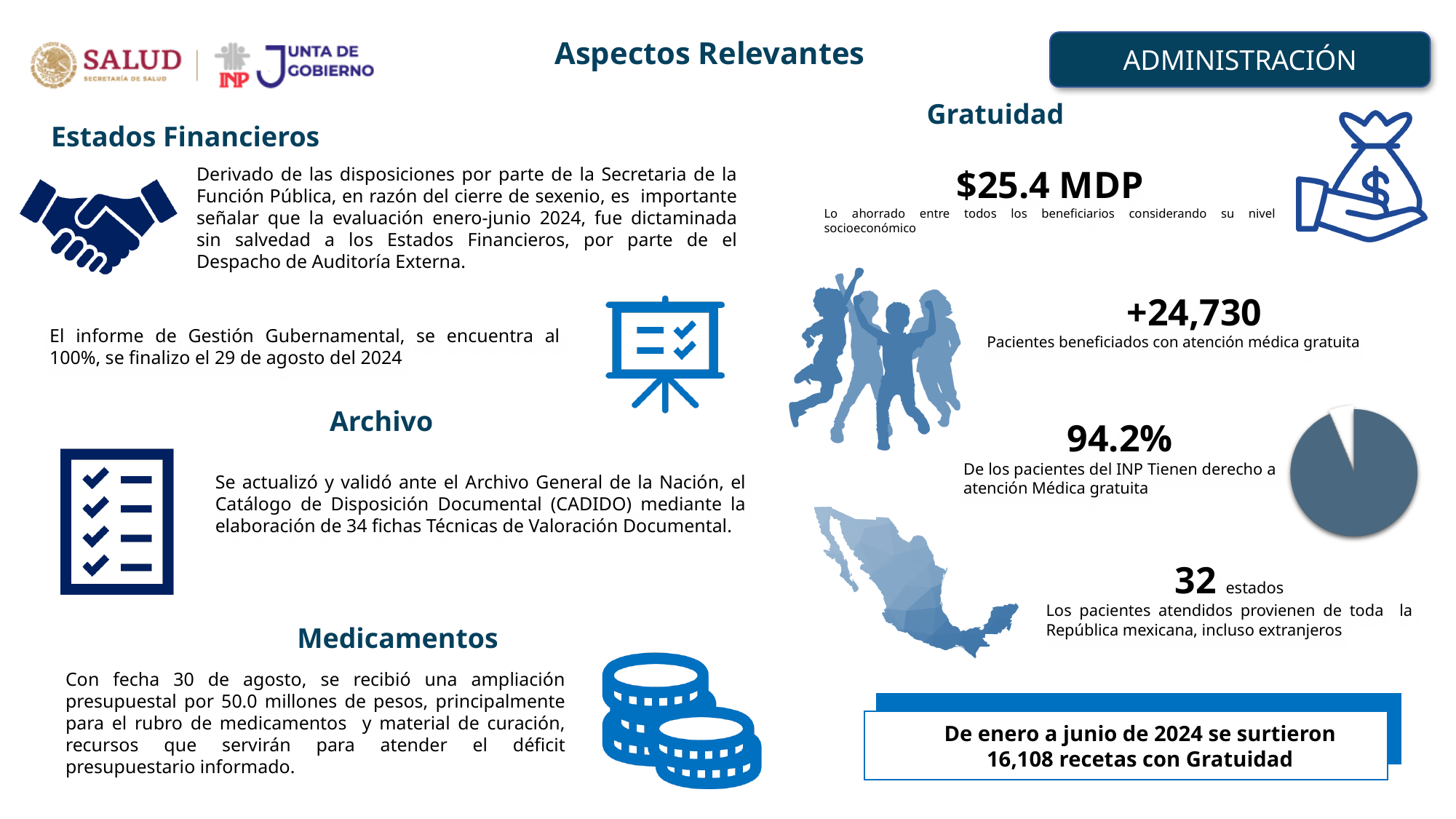
In the pie chart next to the 94.2% figure, is the dark slice or the white slice larger? the dark slice What colour is the large slice of the pie chart in the Gratuidad section? dark slate blue What kind of chart is shown next to the 94.2% figure in the Gratuidad section? pie chart What share of the pie chart in the Gratuidad section does the large dark slice represent, according to the figure printed beside it? 94.2% How many slices does the pie chart in the Gratuidad section have? 2 Does the pie chart in the Gratuidad section have a legend? No